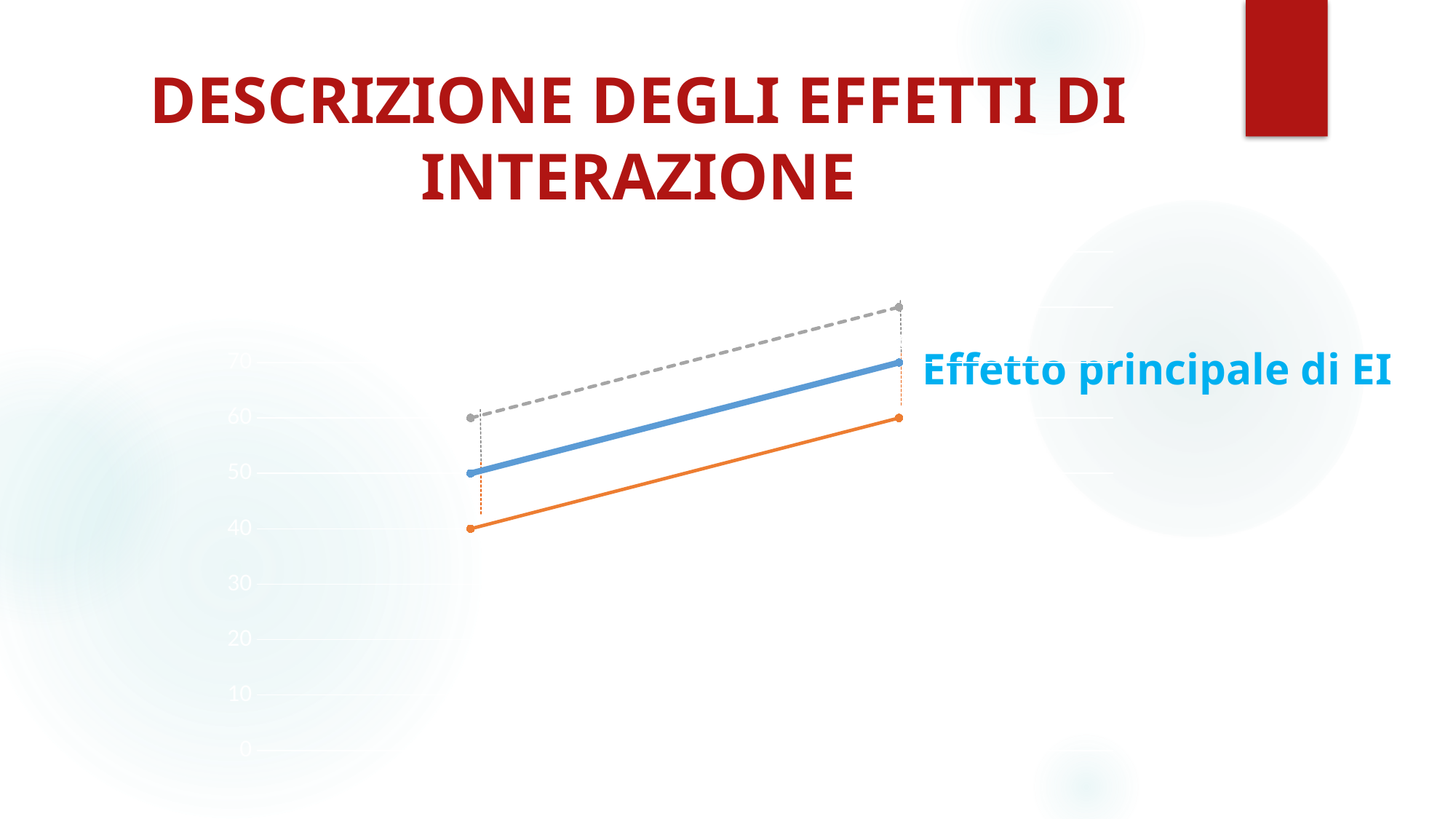
What kind of chart is shown on the slide? line chart How many lines are plotted on the chart? 3 Which line is the lowest on the chart: the gray dashed line, the blue line, or the orange line? the orange line Is the value of the blue line at its left end greater or less than 60? less What is the title of the slide? DESCRIZIONE DEGLI EFFETTI DI INTERAZIONE Do the lines on the chart rise or fall from left to right? rise At the right end of the chart, which is higher: the blue line or the orange line? the blue line Which line is the highest on the chart: the gray dashed line, the blue line, or the orange line? the gray dashed line Is the value of the gray dashed line at its right end greater or less than 70? greater Is the value of the orange line at its left end greater or less than 50? less What text label appears to the right of the chart? Effetto principale di EI At the left end of the chart, which is higher: the gray dashed line or the blue line? the gray dashed line